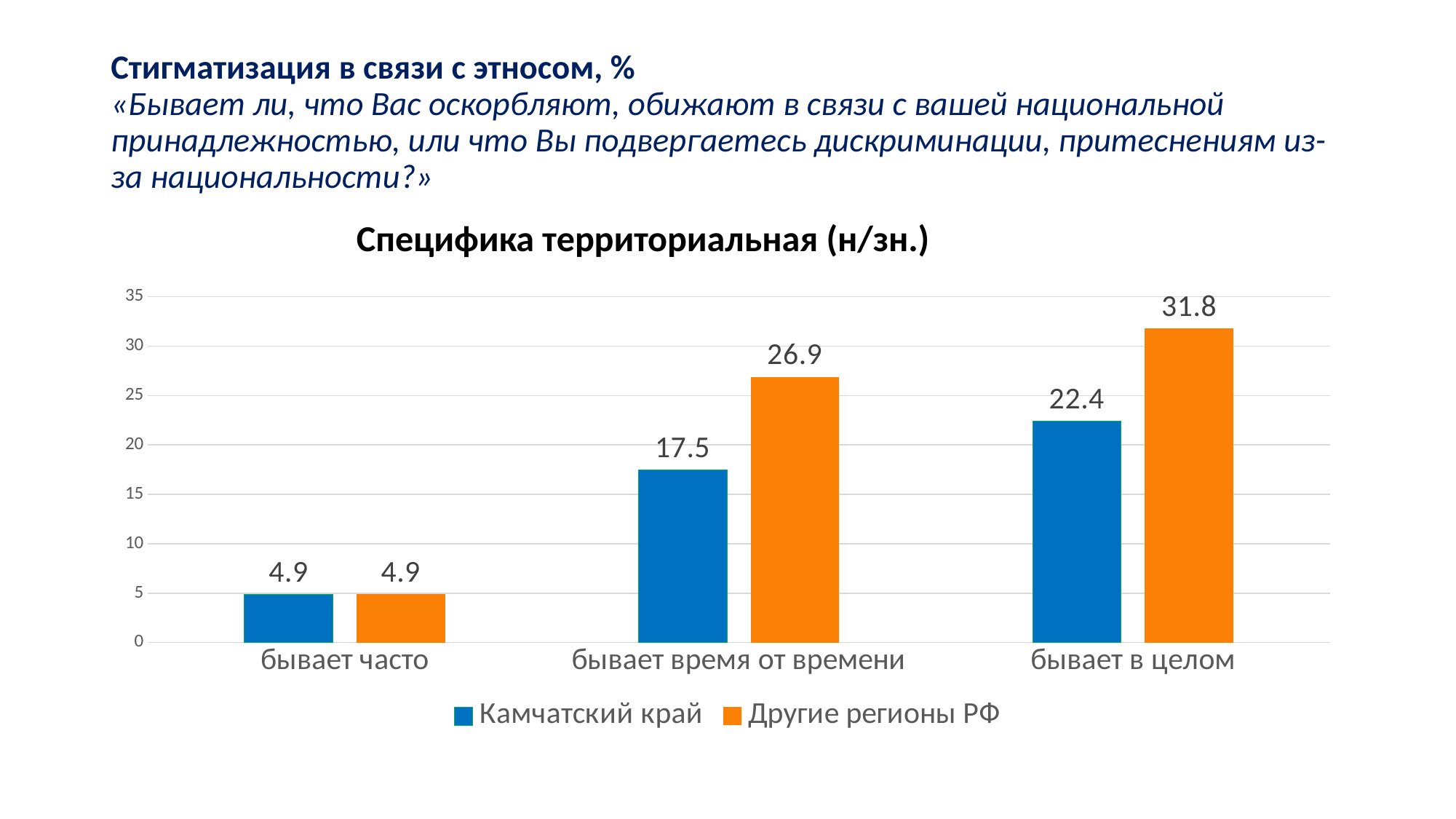
In the category «бывает время от времени», which series has the larger value, Камчатский край or Другие регионы РФ? Другие регионы РФ What is the value for Другие регионы РФ in the category «бывает в целом»? 31.8 Which category has the highest value for Другие регионы РФ? бывает в целом How many series does the legend list? 2 What is the difference between Другие регионы РФ and Камчатский край in the category «бывает в целом»? 9.4 How many categories are shown on the x axis? 3 What is the value for Камчатский край in the category «бывает время от времени»? 17.5 What is the value for Другие регионы РФ in the category «бывает часто»? 4.9 What is the difference between Другие регионы РФ and Камчатский край in the category «бывает время от времени»? 9.4 Which category has the lowest value for Камчатский край? бывает часто What is the title of the chart? Специфика территориальная (н/зн.) What kind of chart is shown on the slide? bar chart